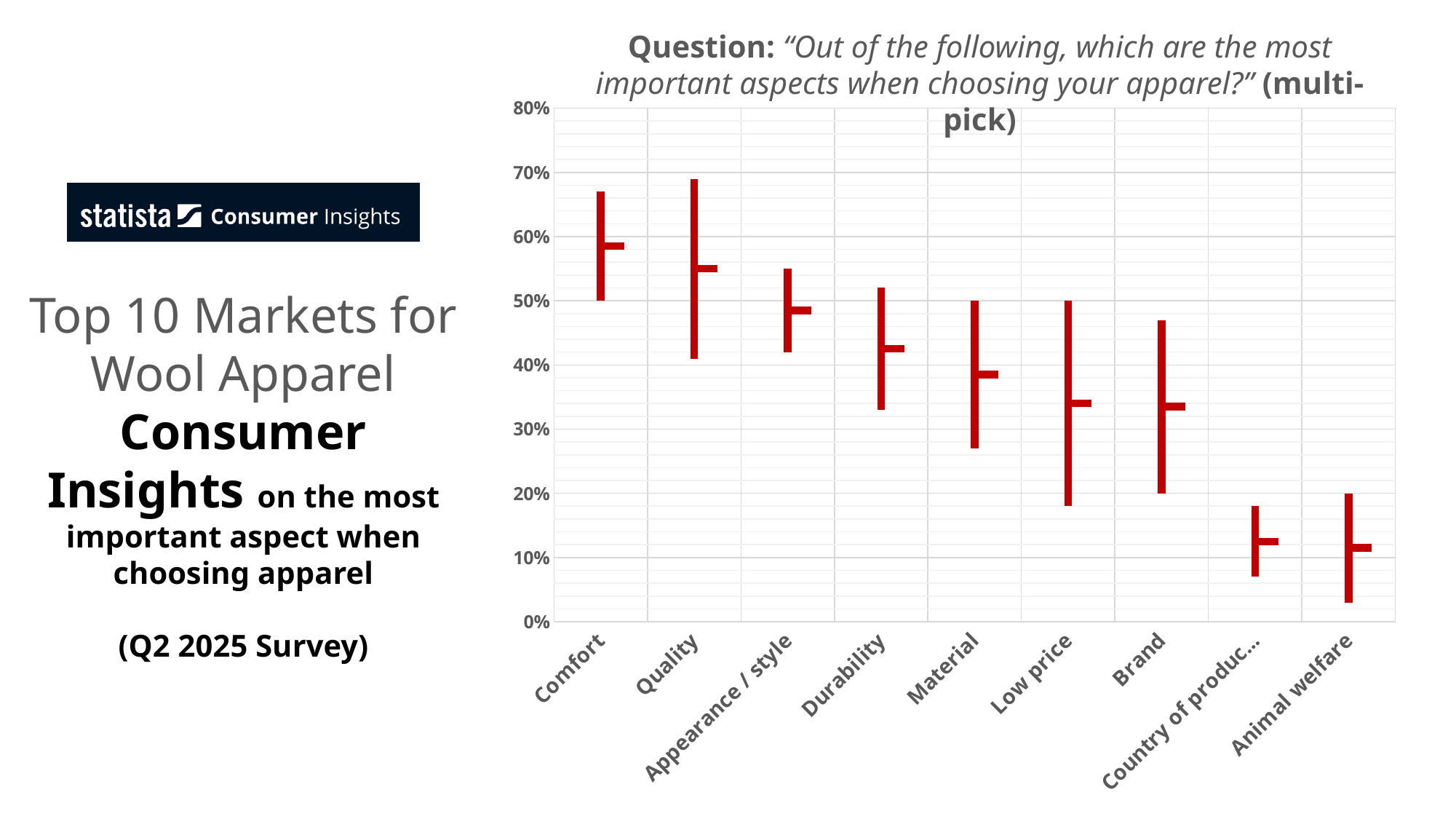
Which has the larger marked value, Comfort or Brand? Comfort What colour are the range lines plotted in the chart? Red Is the top of the range for Brand greater or less than 50%? less Is the top of the range for Quality greater or less than 70%? less Do the marked values generally rise or fall moving from left to right along the x axis? fall How many categories are shown on the x axis of the chart? 9 Is the marked value for Animal welfare greater or less than 20%? less Which category has the highest marked (tick) value in the chart? Comfort